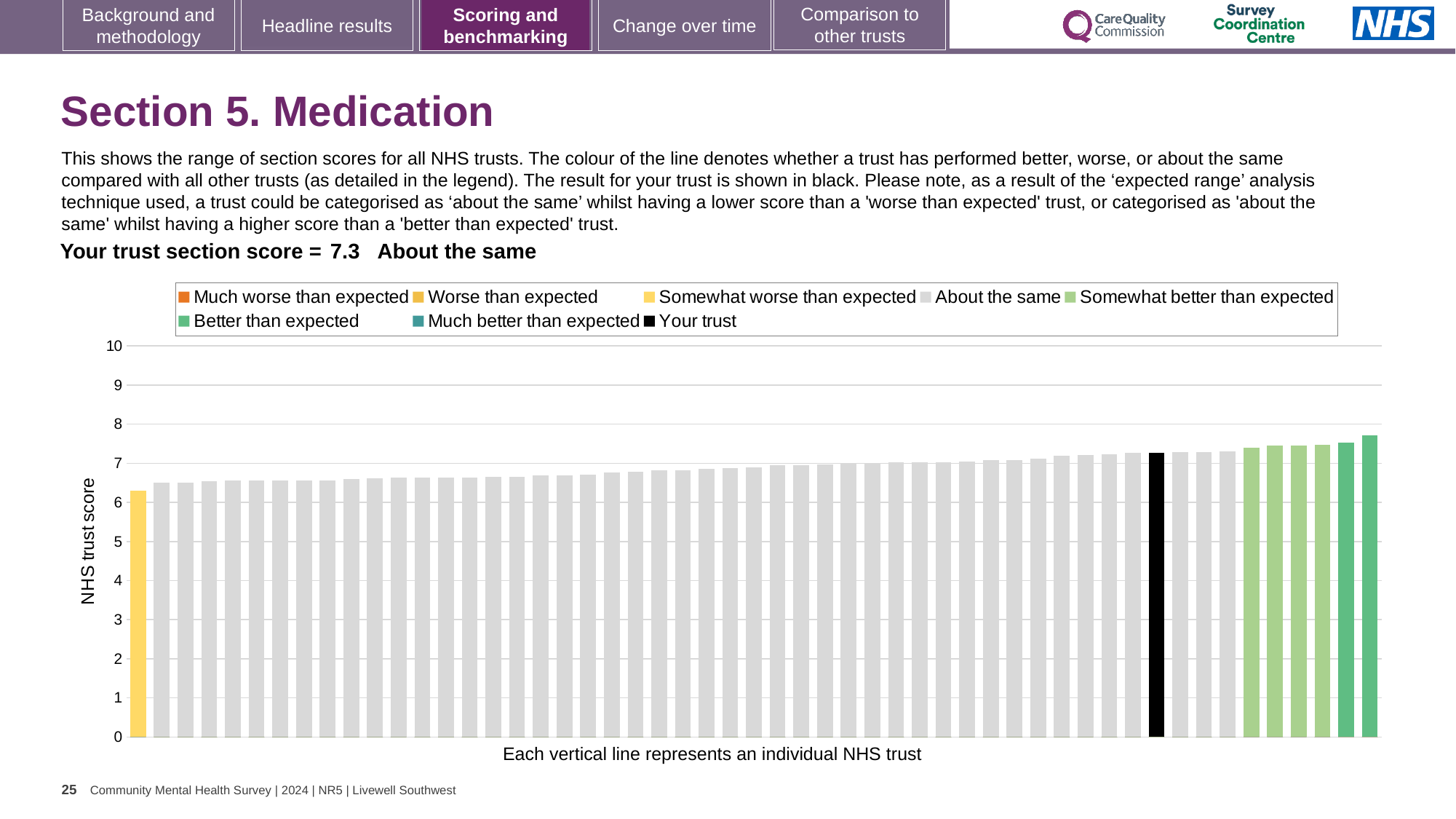
Do the bar values rise or fall from left to right along the x axis? rise Is the value of the rightmost bar greater or less than 8? less What is the section score for your trust shown on the slide? 7.3 What colour is the bar representing your trust? black Is the value of the leftmost (yellow) bar greater or less than 7? less Is the value of the lowest bar greater or less than 6? greater What kind of chart is shown on the slide? bar chart Which category is your trust's section score placed in? About the same What is the label on the vertical axis of the chart? NHS trust score How many entries does the chart legend list? 8 Which is larger, the leftmost bar or the rightmost bar? the rightmost bar